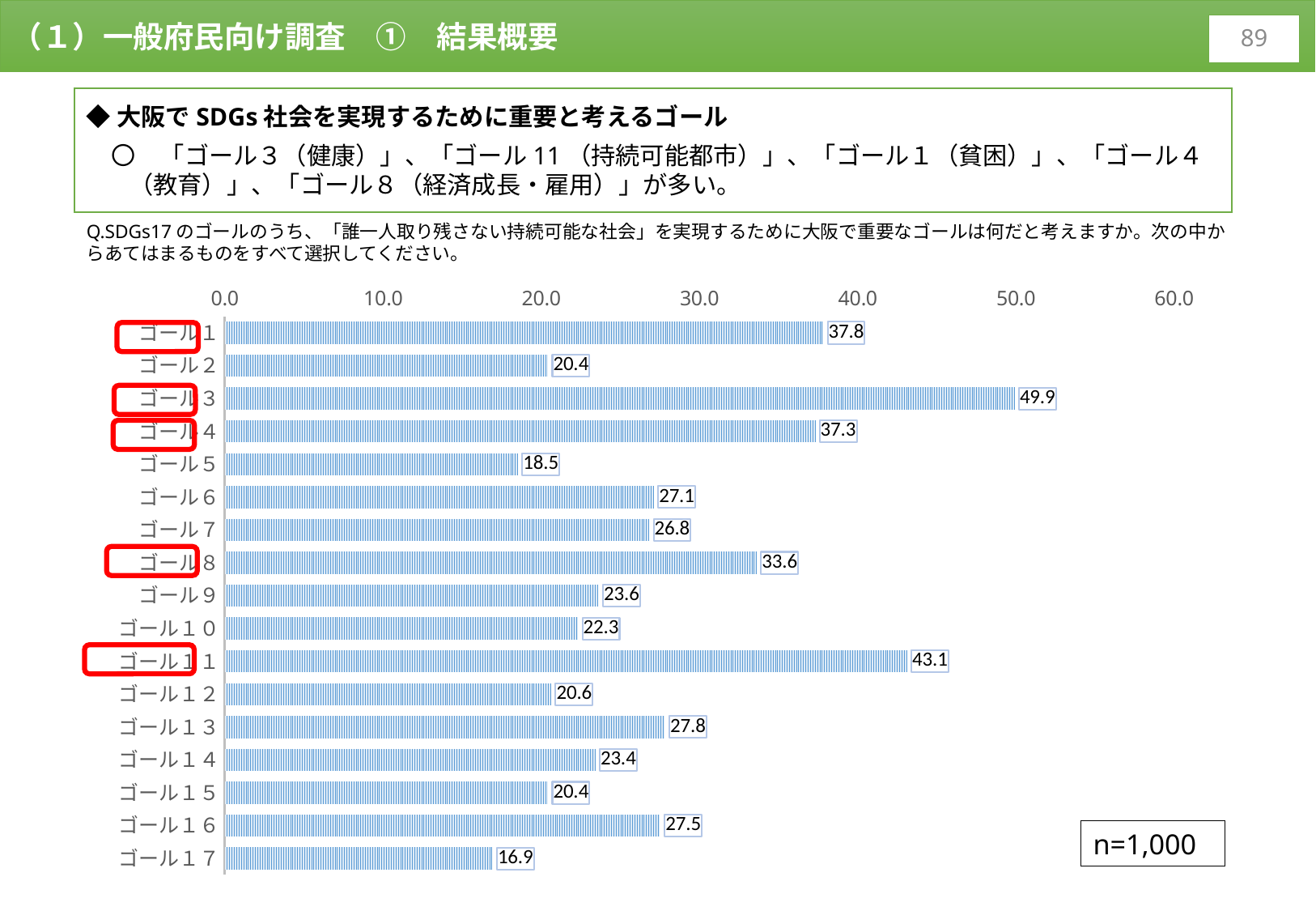
What is the value for ゴール１１? 43.1 Which is larger, the value for ゴール１ or the value for ゴール４? ゴール１ What is the difference between the values for ゴール３ and ゴール１１? 6.8 How many categories are shown in the chart? 17 Which category has the lowest value? ゴール１７ What is the difference between the values for ゴール１ and ゴール１７? 20.9 Which category has the highest value? ゴール３ Is the value for ゴール８ greater or less than 30.0? greater What kind of chart is shown on the slide? bar chart What is the value for ゴール３? 49.9 What sample size is shown in the box next to the chart? n=1,000 What is the value for ゴール１７? 16.9